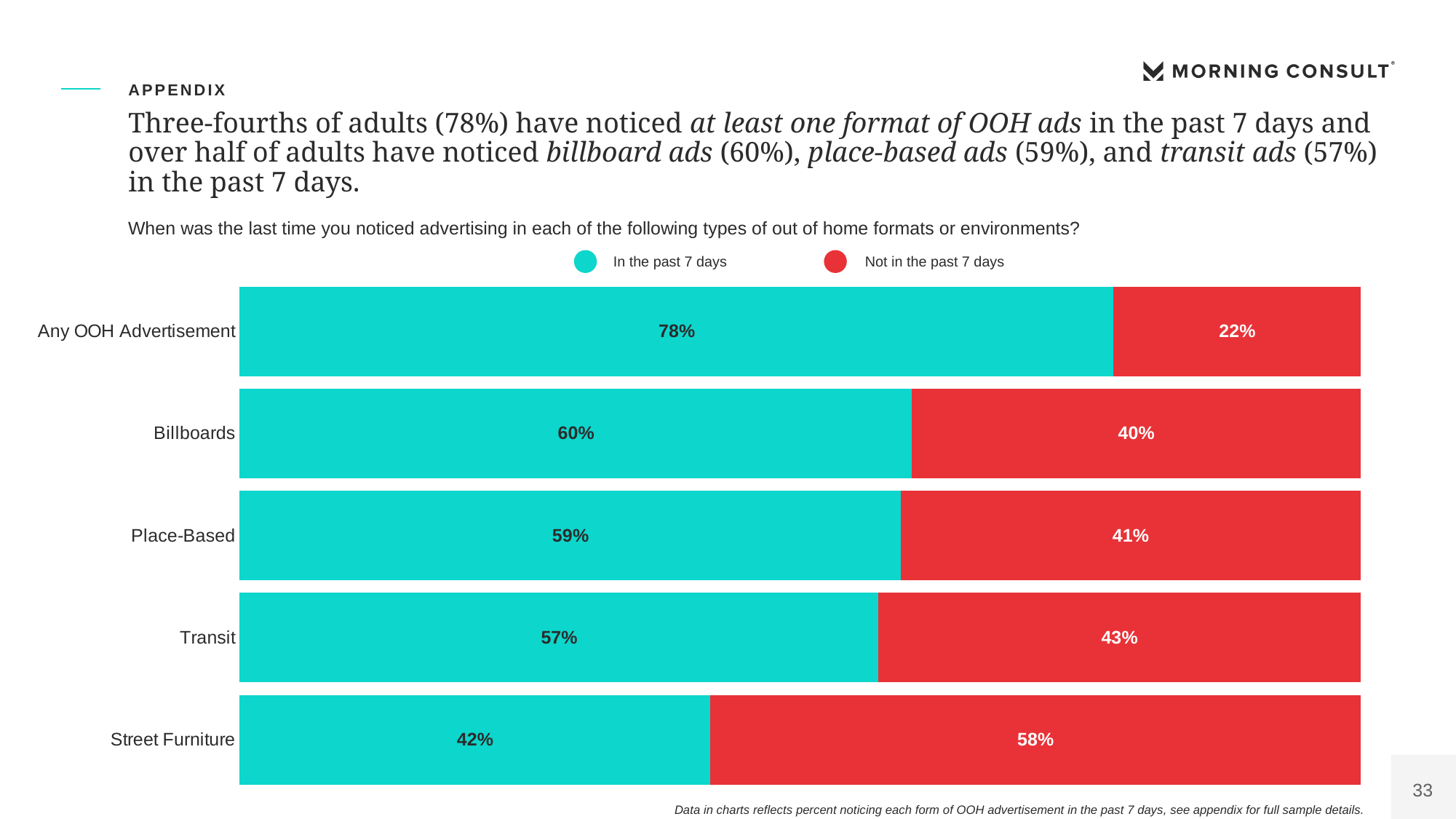
Which category has the highest 'In the past 7 days' value? Any OOH Advertisement Which colour represents 'Not in the past 7 days' in the legend? Red Which category has the lowest 'In the past 7 days' value? Street Furniture What is the total of the stacked bar for Place-Based? 100% How many categories are shown in the chart? 5 What is the 'In the past 7 days' value for Transit? 57% What percentage of adults noticed Billboards advertising in the past 7 days? 60% What is the 'Not in the past 7 days' value for Street Furniture? 58% What is the difference between the 'In the past 7 days' values for Billboards and Street Furniture? 18 percentage points How many series does the legend list? 2 Which is larger: the 'Not in the past 7 days' value for Transit or for Place-Based? Transit What kind of chart is shown on the slide? Stacked bar chart